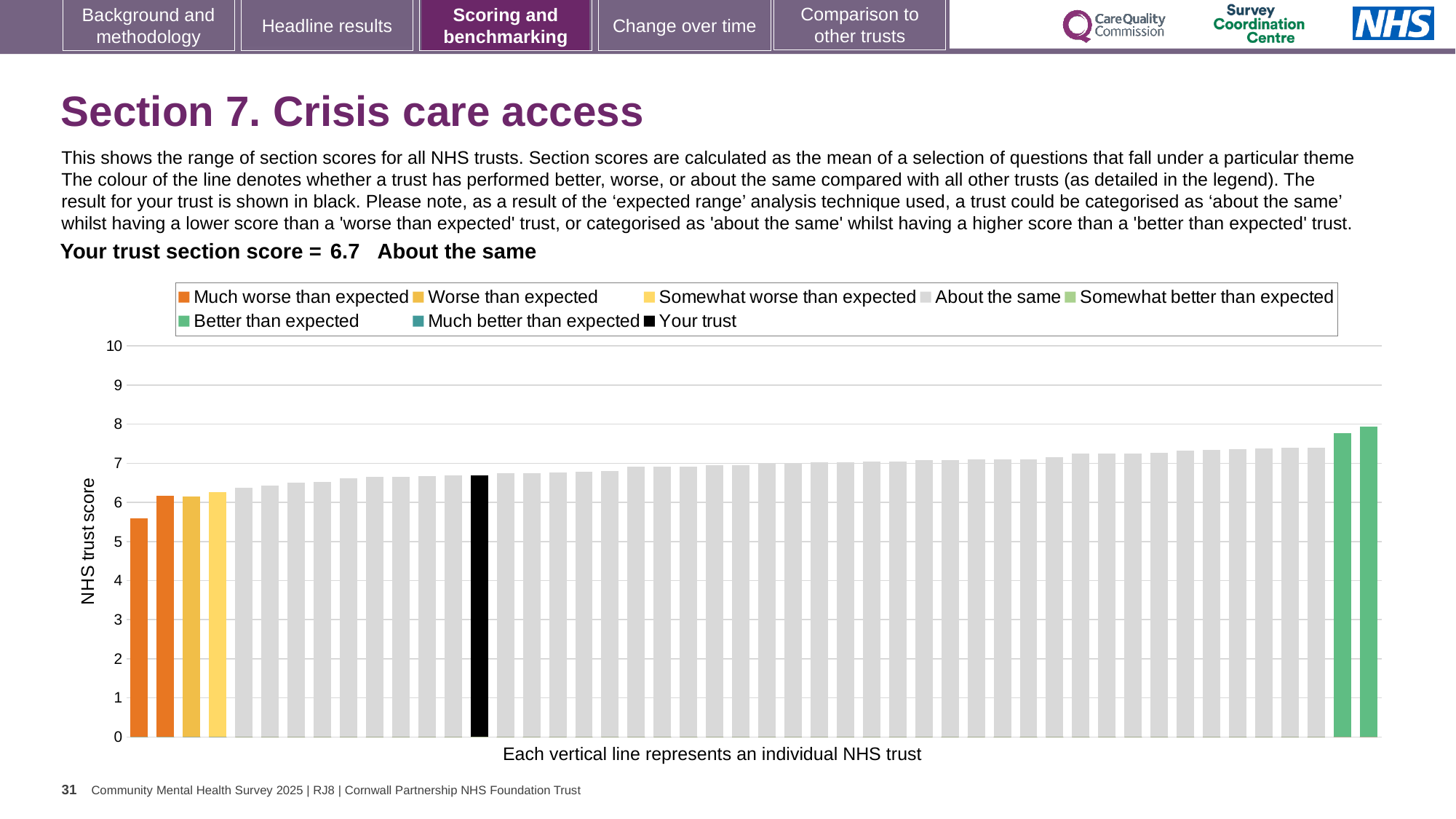
How many bars are coloured green (better than expected)? 2 Is the value of the rightmost (highest) bar greater or less than 7? greater What is the section score for your trust shown on the slide? 6.7 Which category is your trust placed in for this section? About the same What kind of chart is shown on the slide? Bar chart Is the bar for your trust higher or lower than the leftmost bar? higher Do the bar values rise or fall from left to right along the x axis? rise What is the label on the vertical axis of the chart? NHS trust score Is the value of the leftmost (lowest) bar greater or less than 6? less Is the value for your trust (the black bar) greater or less than 5? greater How many bars are coloured orange (much worse than expected)? 2 How many entries does the chart legend list? 8